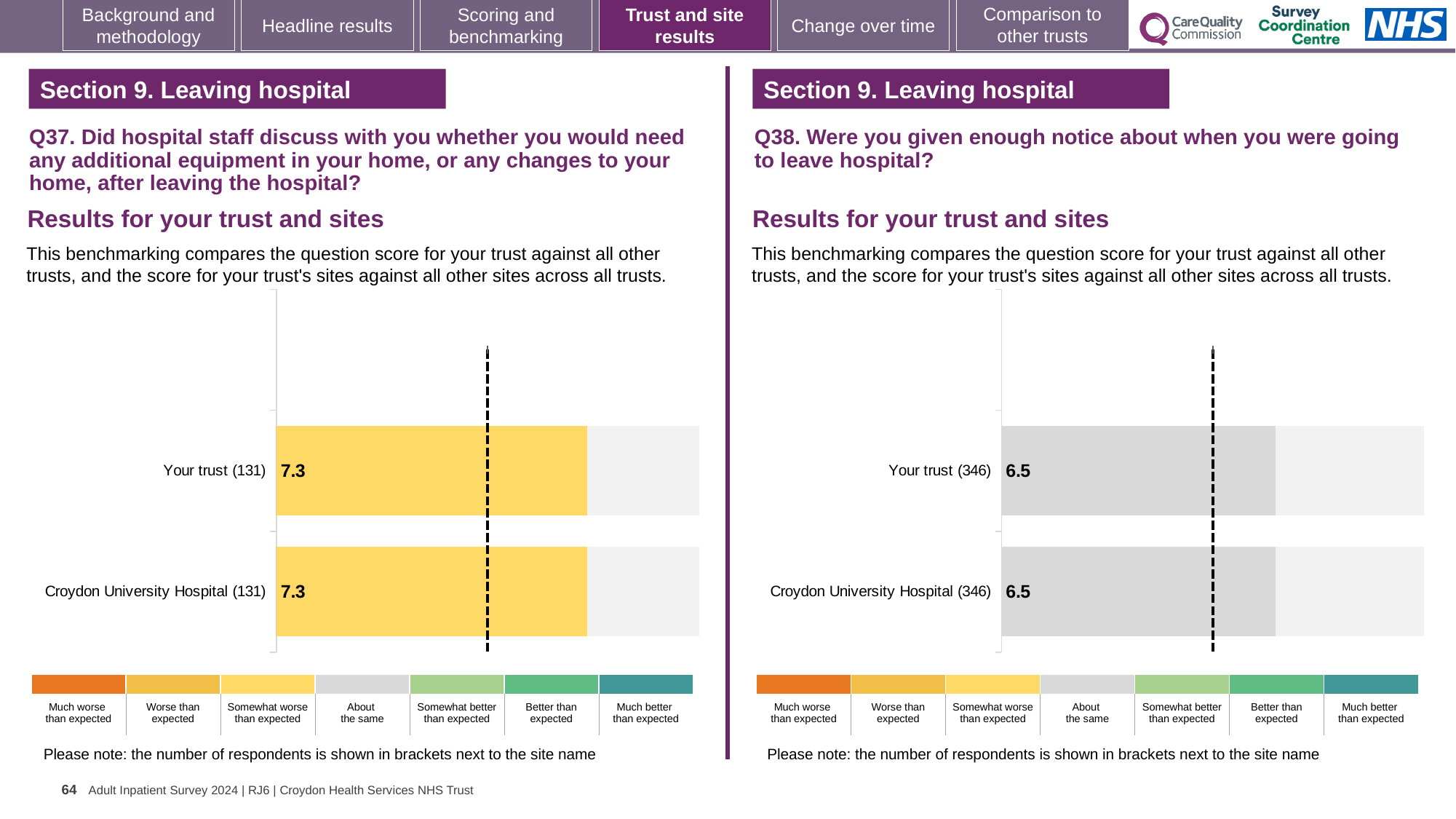
How many bars are plotted on the Q37 chart (left)? 2 On the Q38 chart (right), which benchmark category does the colour of the bars correspond to according to the key? About the same On the Q38 chart (right), what is the score for Your trust (346)? 6.5 On the Q37 chart (left), which benchmark category does the colour of the bars correspond to according to the key? Somewhat worse than expected What kind of chart is used on the Q38 chart (right)? Bar chart How many bars are plotted on the Q38 chart (right)? 2 On the Q37 chart (left), what is the score for Croydon University Hospital (131)? 7.3 On the Q37 chart (left), what is the score for Your trust (131)? 7.3 On the Q37 chart (left), what is the difference between the score for Your trust and the score for Croydon University Hospital? 0 On the Q38 chart (right), what is the difference between the score for Your trust and the score for Croydon University Hospital? 0 On the Q37 chart (left), how many respondents are shown in brackets for Croydon University Hospital? 131 On the Q38 chart (right), what is the score for Croydon University Hospital (346)? 6.5